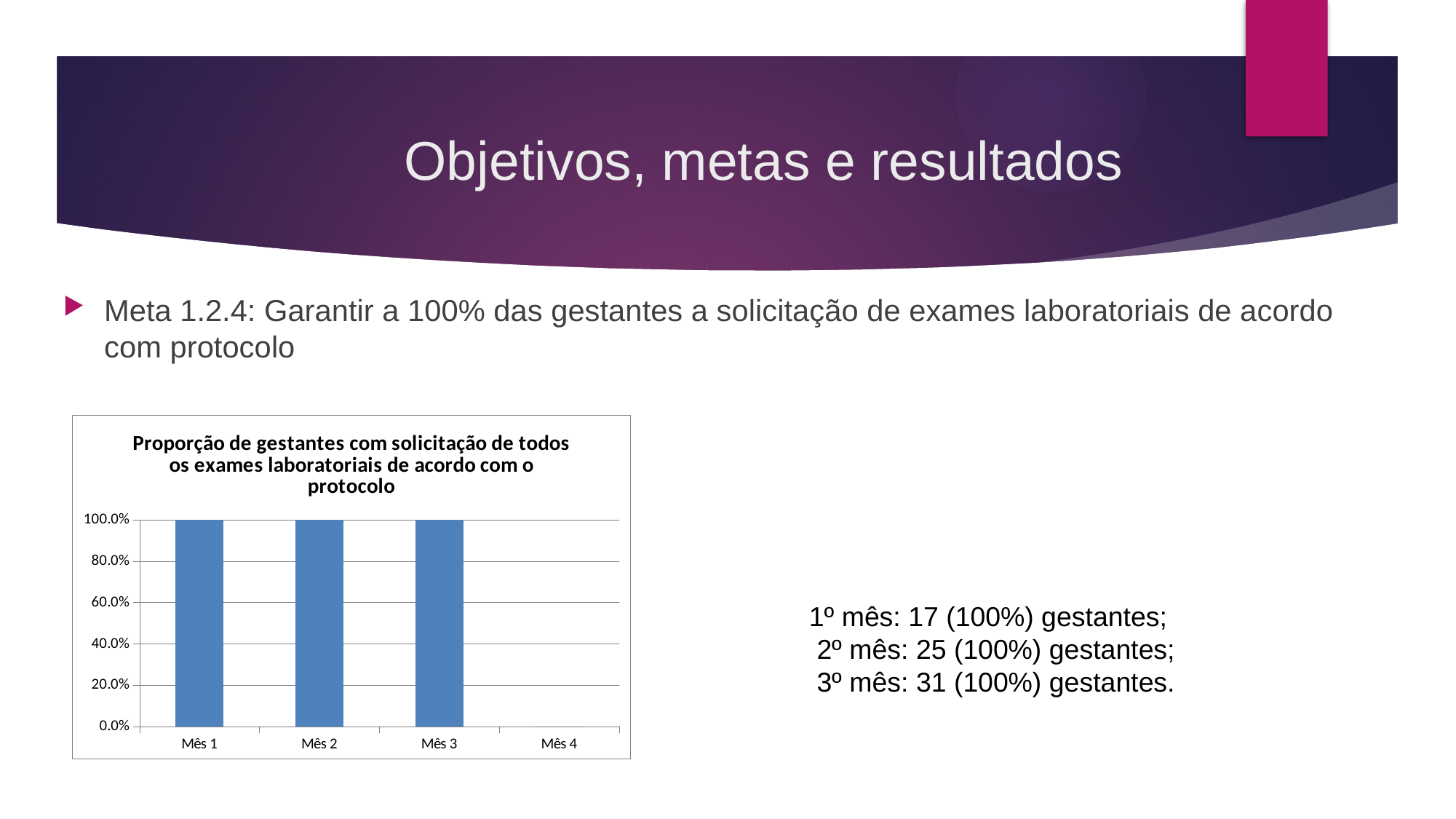
Is the value for Mês 2 greater or less than 80.0%? greater Which category has the lowest value in the chart? Mês 4 What is the value for Mês 2 in the chart? 100.0% How many categories are shown on the x axis of the chart? 4 What is the value for Mês 1 in the chart? 100.0% What is the highest value shown on the y axis of the chart? 100.0% What kind of chart is shown on the slide? bar chart What is the title of the chart? Proporção de gestantes com solicitação de todos os exames laboratoriais de acordo com o protocolo What is the value for Mês 3 in the chart? 100.0% Is the value for Mês 3 greater or less than 60.0%? greater Do the values rise, fall or stay flat from Mês 1 to Mês 3? stay flat Is there a bar plotted for Mês 4 in the chart? No